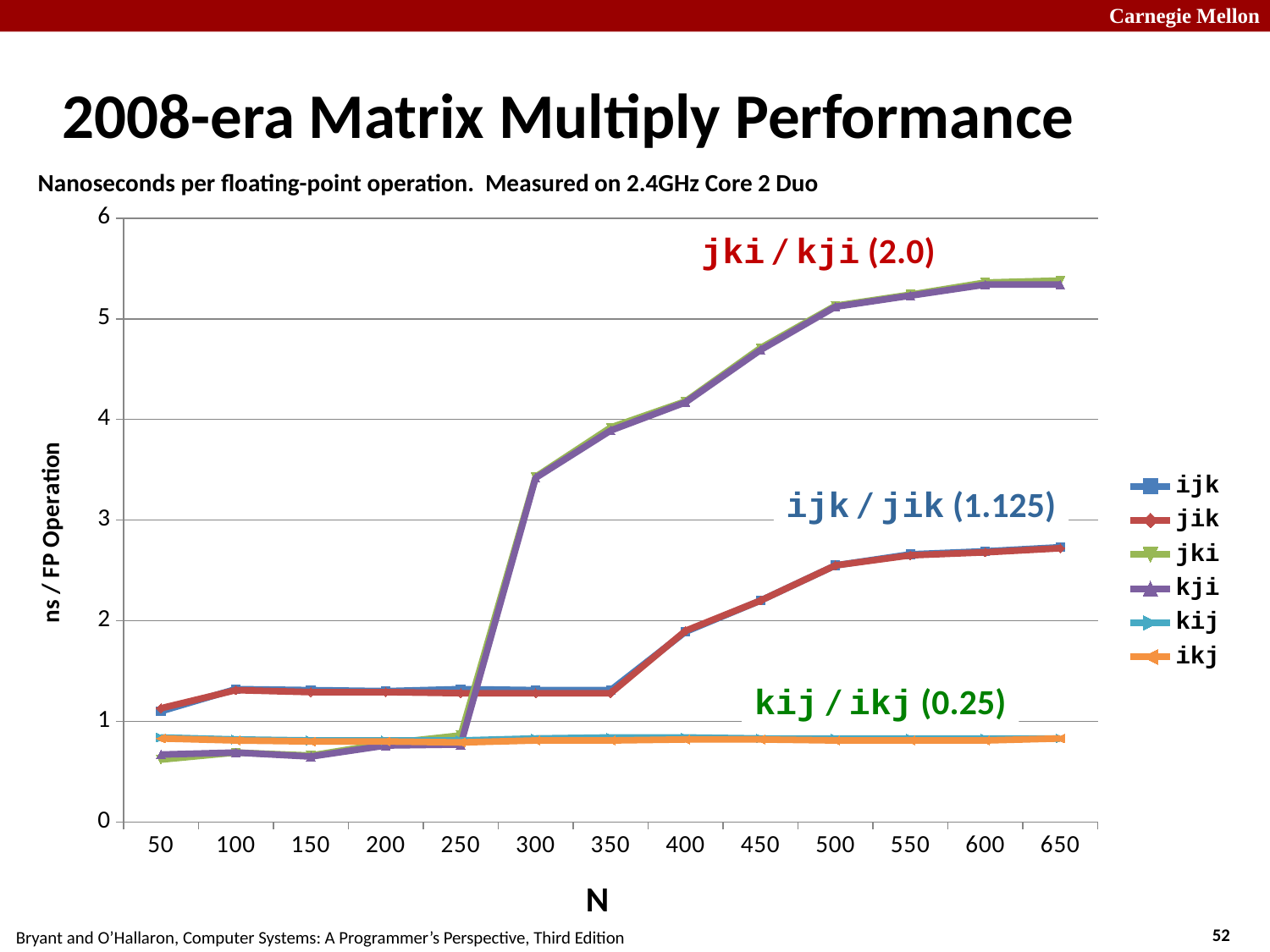
Is the value for jki at N = 650 greater or less than 5? greater What is the label on the y axis of the chart? ns / FP Operation For the jki series, at which value of N is the value lowest? 50 Is the value for ijk at N = 300 greater or less than 2? less How many series does the legend list? 6 Is the value for kji at N = 300 greater or less than 3? greater How many values of N are plotted along the x axis? 13 At N = 50, which is larger, the value for ijk or the value for jki? ijk Do the values for the kji series rise or fall as N increases from 250 to 650? rise What kind of chart is shown on the slide? line chart At N = 650, which is larger, the value for jki or the value for ijk? jki